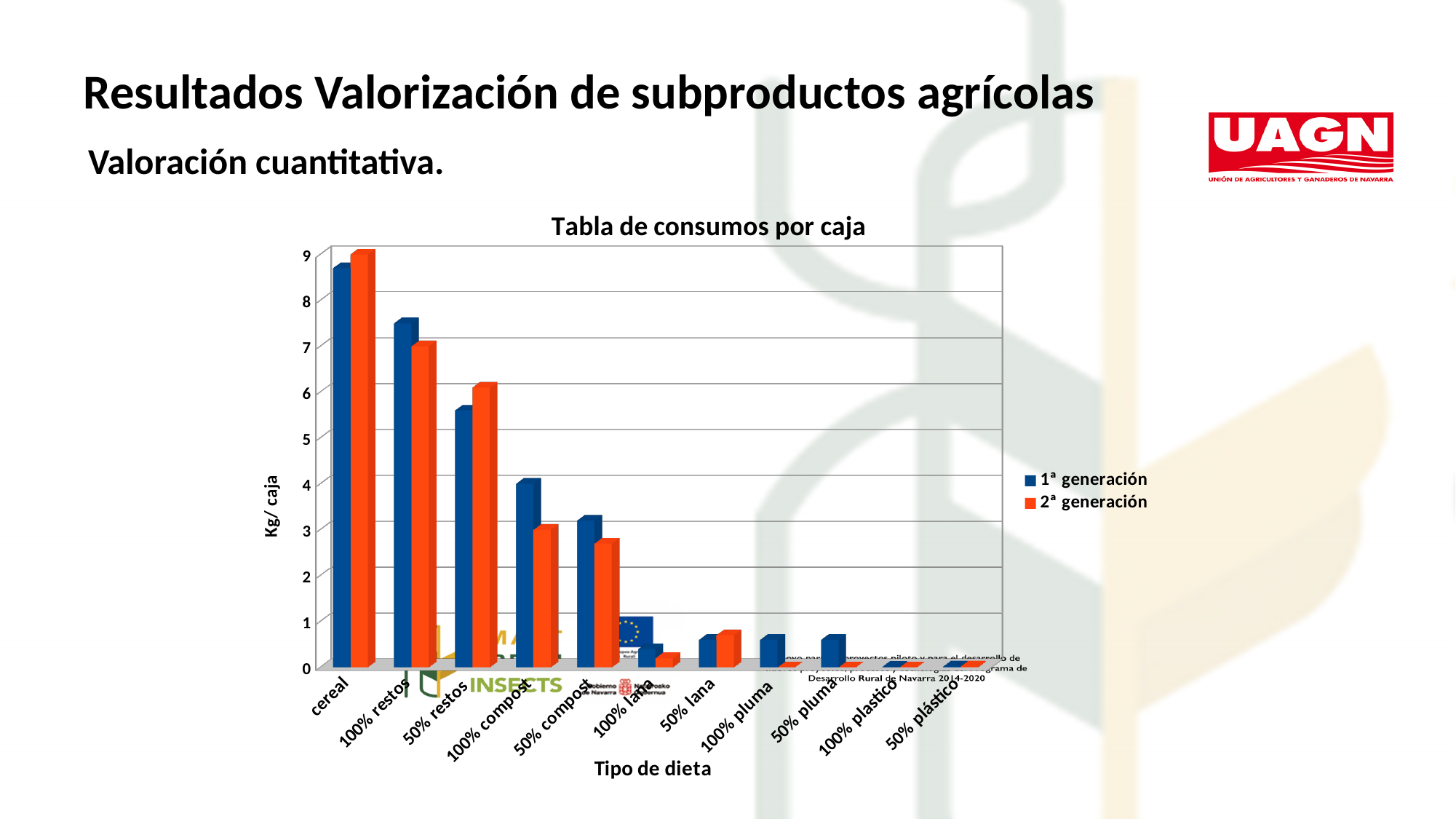
Which diet type has the highest value for 1ª generación in 'Tabla de consumos por caja'? cereal Is the 2ª generación value for 100% compost greater or less than 4 in 'Tabla de consumos por caja'? less How many series does the legend of 'Tabla de consumos por caja' list? 2 What type of chart is 'Tabla de consumos por caja'? bar chart Is the 2ª generación value for 100% lana greater or less than 1 in 'Tabla de consumos por caja'? less For 100% restos, which series has the larger value in 'Tabla de consumos por caja': 1ª generación or 2ª generación? 1ª generación Which diet type has the highest value for 2ª generación in 'Tabla de consumos por caja'? cereal Is the 1ª generación value for cereal greater or less than 8 in 'Tabla de consumos por caja'? greater For 100% compost, which series has the larger value in 'Tabla de consumos por caja': 1ª generación or 2ª generación? 1ª generación Do the 1ª generación values in 'Tabla de consumos por caja' generally rise or fall from cereal to 50% plástico along the x axis? fall How many diet types (categories) are shown on the x axis of 'Tabla de consumos por caja'? 11 What is the y-axis label of 'Tabla de consumos por caja'? Kg/ caja